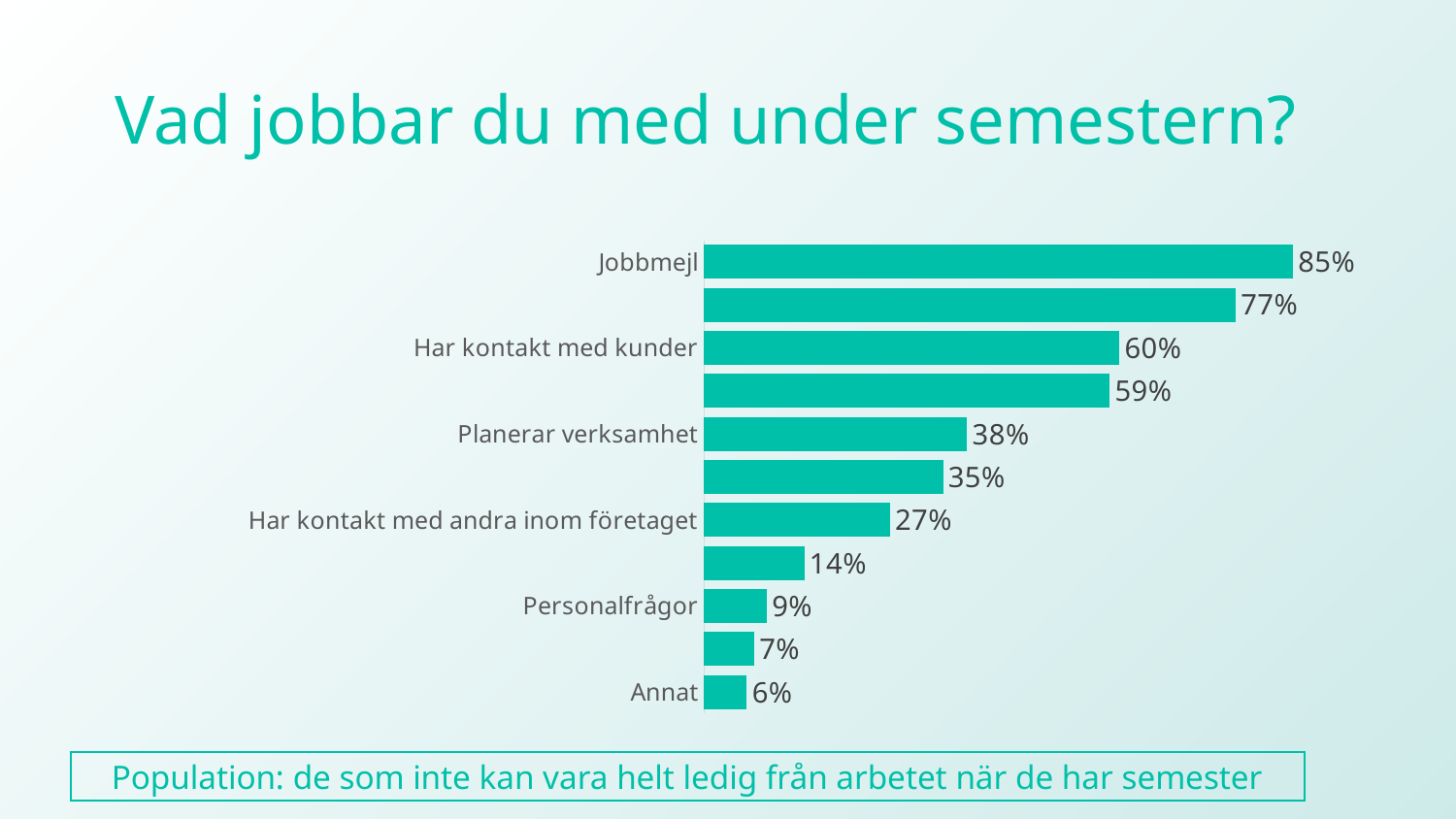
What is the value for Jobbmejl? 85% What is the value for Har kontakt med andra inom företaget? 27% What is the difference between the values for Jobbmejl and Har kontakt med kunder? 25% What is the title of the chart? Vad jobbar du med under semestern? Which category has the highest value? Jobbmejl What is the value for Planerar verksamhet? 38% Which is larger, the value for Planerar verksamhet or the value for Personalfrågor? Planerar verksamhet What is the value for Har kontakt med kunder? 60% What is the value for Annat? 6% Which category has the lowest value? Annat What kind of chart is shown on the slide? bar chart What is the value for Personalfrågor? 9%